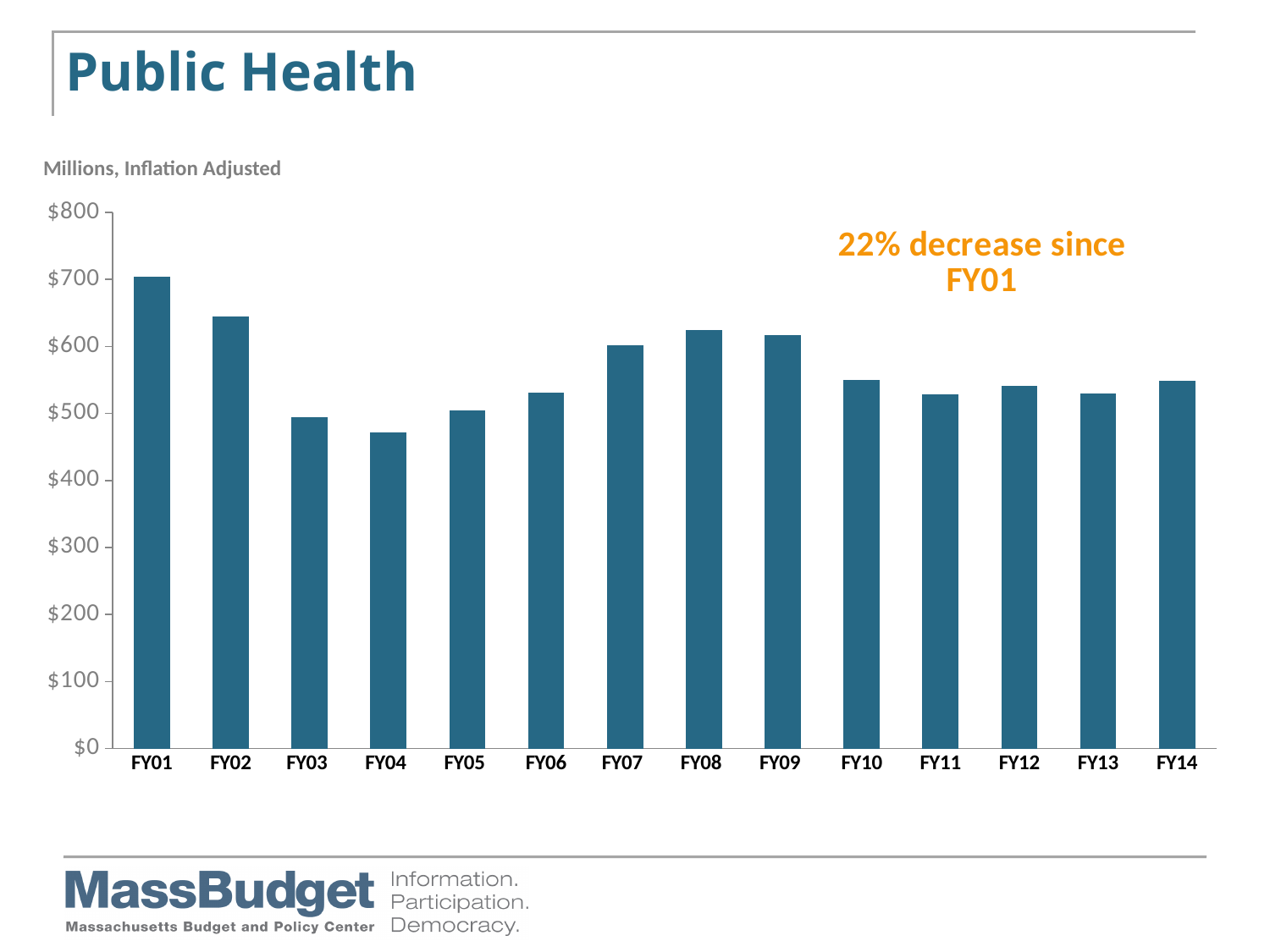
Is the value for FY08 greater or less than $600? greater Is the value for FY01 greater or less than $600? greater Which is larger, the value for FY08 or the value for FY05? FY08 Do the values rise or fall from FY01 to FY04? fall Which is larger, the value for FY01 or the value for FY14? FY01 Which fiscal year has the lowest value? FY04 Which fiscal year has the highest value? FY01 How many fiscal years are plotted on the chart? 14 Is the value for FY04 greater or less than $500? less What kind of chart is shown on the slide? bar chart What percentage decrease since FY01 does the annotation on the chart state? 22%